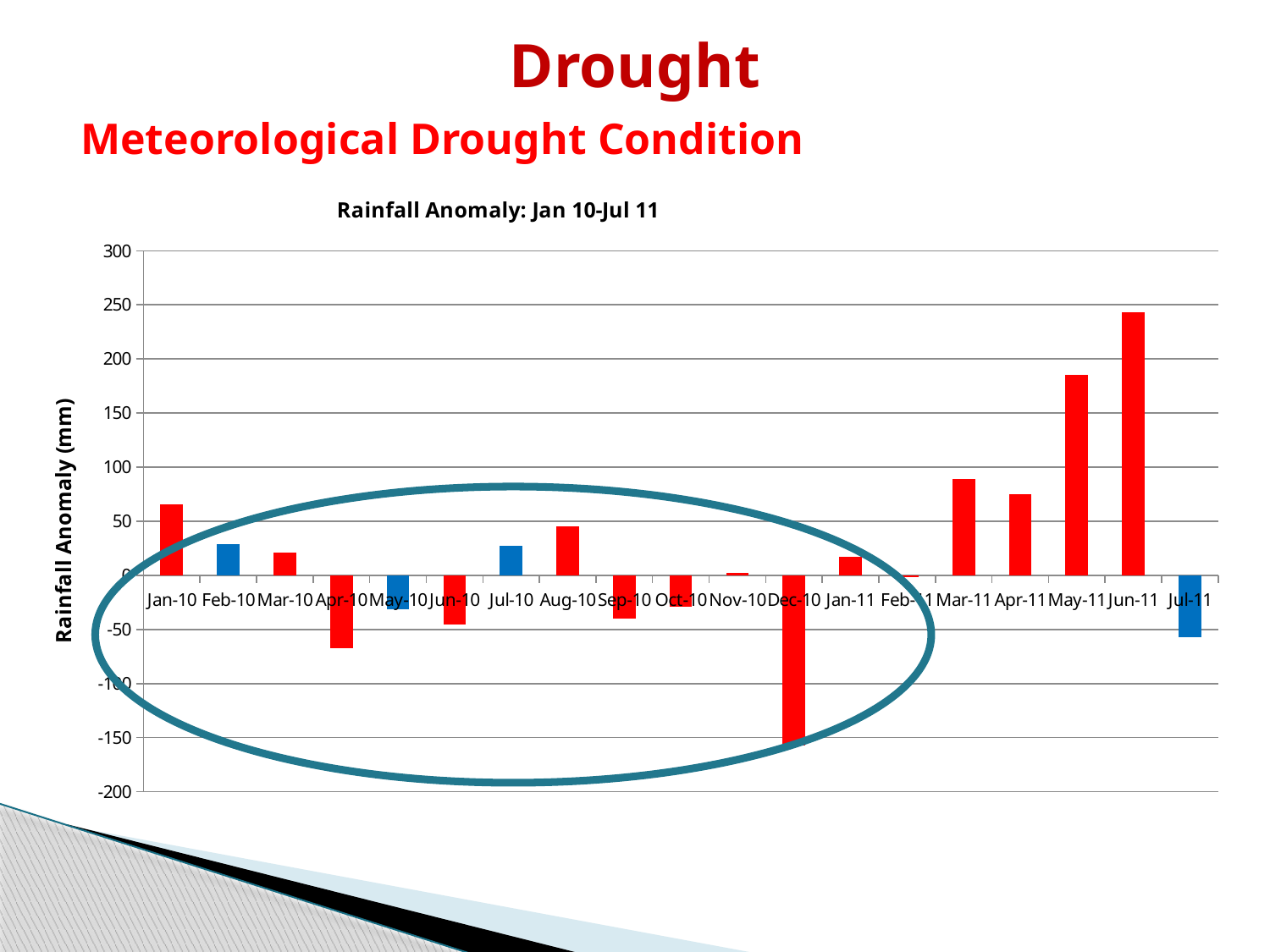
Is the value for Apr-10 greater or less than -50? less Is the value for May-11 greater or less than 150? greater What is the label of the vertical axis? Rainfall Anomaly (mm) Which month has the lowest rainfall anomaly? Dec-10 What is the title of the chart? Rainfall Anomaly: Jan 10-Jul 11 Is the value for Dec-10 greater or less than -100? less Which is larger, the value for May-11 or the value for Apr-11? May-11 Do the values rise or fall from Apr-11 to Jun-11? rise Which month has the highest rainfall anomaly? Jun-11 How many months are plotted on the x axis? 19 What kind of chart is shown on the slide? bar chart